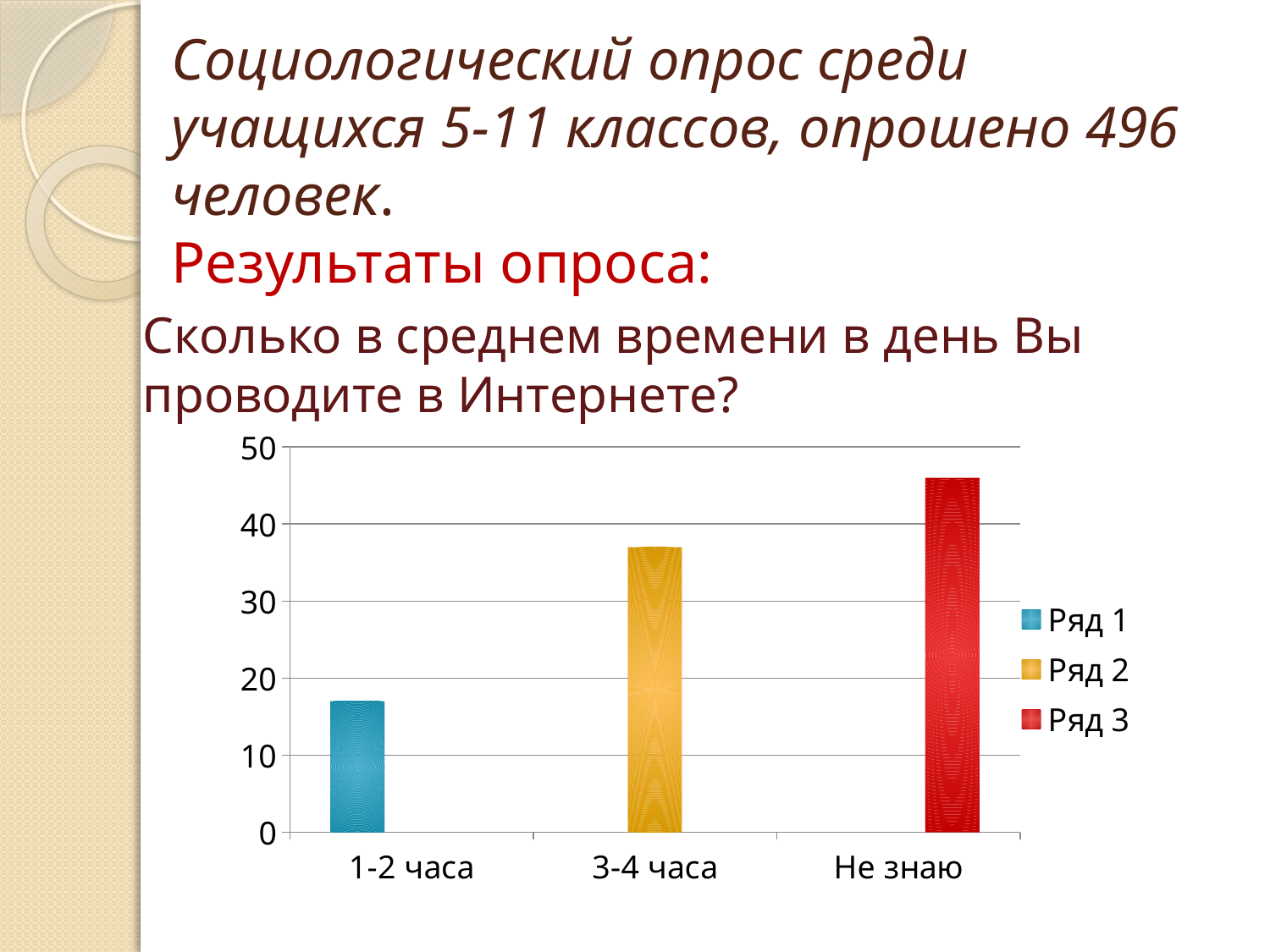
What colour is the bar for Не знаю? red Which category has the highest bar? Не знаю Is the value for Не знаю greater or less than 40? greater Do the bar values rise or fall from left to right along the x axis? rise Is the value for 1-2 часа greater or less than 20? less What is the name of the third series in the legend? Ряд 3 Which category has the lowest bar? 1-2 часа Which is larger, the value for 3-4 часа or the value for 1-2 часа? 3-4 часа What kind of chart is shown on the slide? bar chart How many series does the chart legend list? 3 How many categories are shown on the x axis of the chart? 3 Is the value for 3-4 часа greater or less than 30? greater